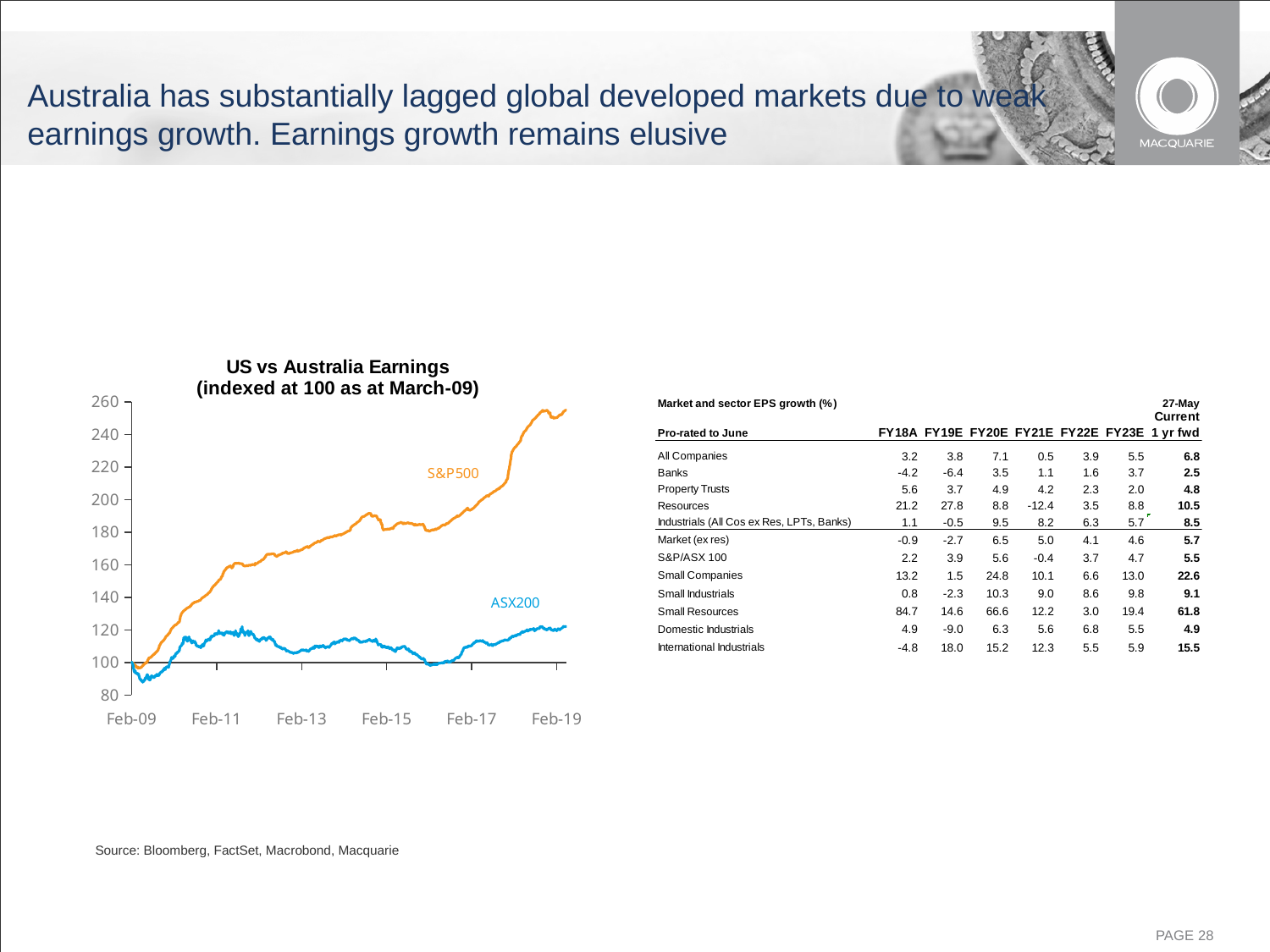
Does the S&P500 line generally rise or fall from Feb-09 to Feb-19? rise Is the value for S&P500 at Feb-19 greater or less than 240? greater Which two series are labelled on the chart? S&P500 and ASX200 Is the value for ASX200 at Feb-11 greater or less than 100? greater Is the value for ASX200 at Feb-17 greater or less than 120? less How many series are plotted in the US vs Australia Earnings chart? 2 Which series is higher at Feb-19, S&P500 or ASX200? S&P500 What kind of chart is shown on the slide? line chart What is the title of the chart on the slide? US vs Australia Earnings (indexed at 100 as at March-09) Which series ends the period at the lower level? ASX200